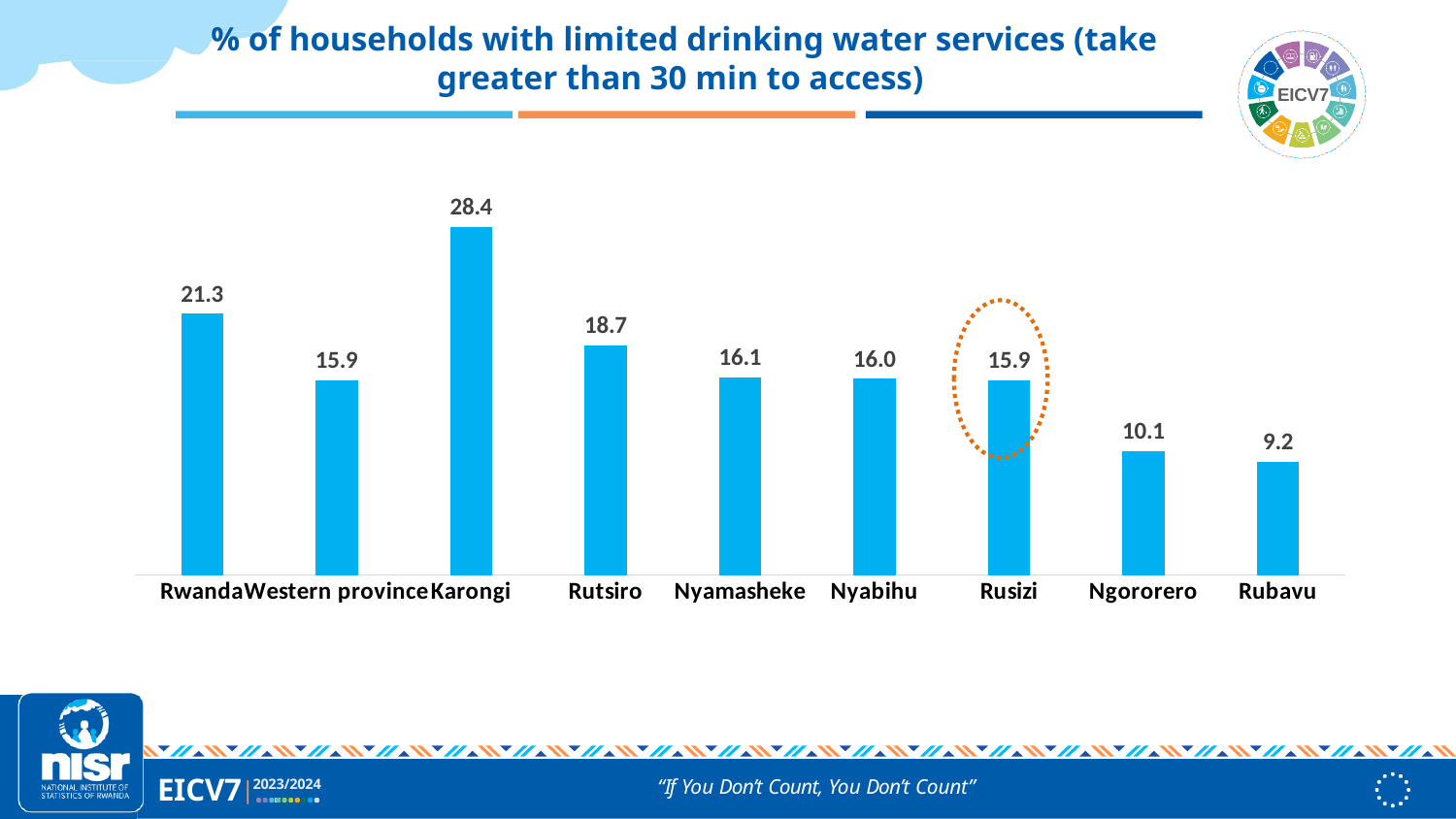
Which is larger, the value for Rutsiro or the value for Nyamasheke? Rutsiro How many categories are shown on the chart? 9 Which category's bar is highlighted with a dotted orange circle? Rusizi What is the value for Rusizi? 15.9 What is the difference between the values for Karongi and Rubavu? 19.2 Which category has the highest value? Karongi What is the value for Ngororero? 10.1 Which category has the lowest value? Rubavu What is the value for Rwanda? 21.3 What kind of chart is shown on the slide? Bar chart What is the value for Karongi? 28.4 What is the difference between the values for Rwanda and Western province? 5.4